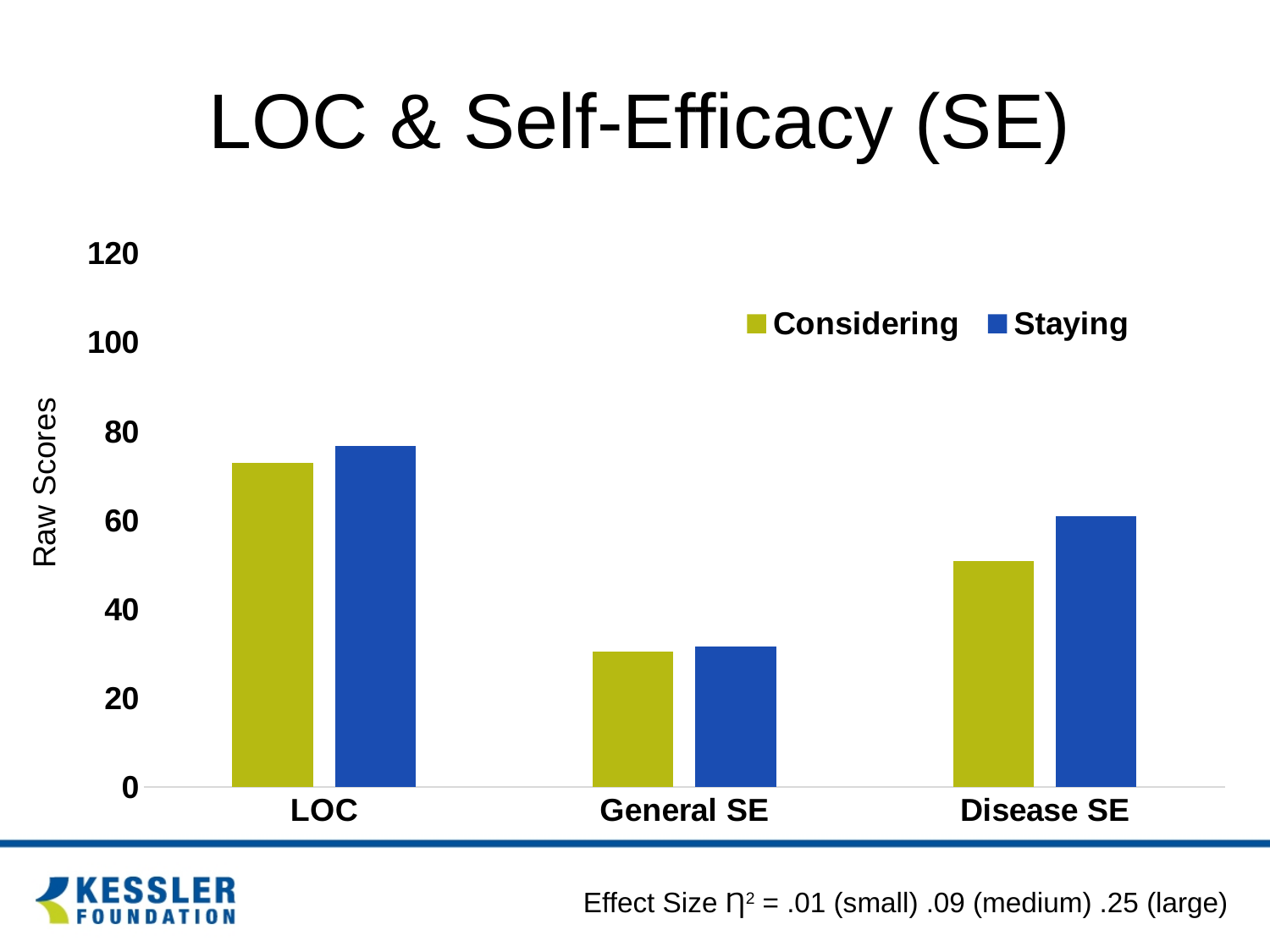
What is the label on the vertical axis? Raw Scores For LOC, which is larger, Considering or Staying? Staying What kind of chart is shown on the slide? bar chart Is the Considering value for Disease SE greater or less than 40? greater Is the Staying value for General SE greater or less than 40? less How many categories are shown on the x axis? 3 Which category has the highest Considering bar? LOC For Disease SE, which is larger, Considering or Staying? Staying Which category has the lowest Staying bar? General SE Is the Considering value for LOC greater or less than 60? greater How many series does the legend list? 2 What colour are the Staying bars? blue